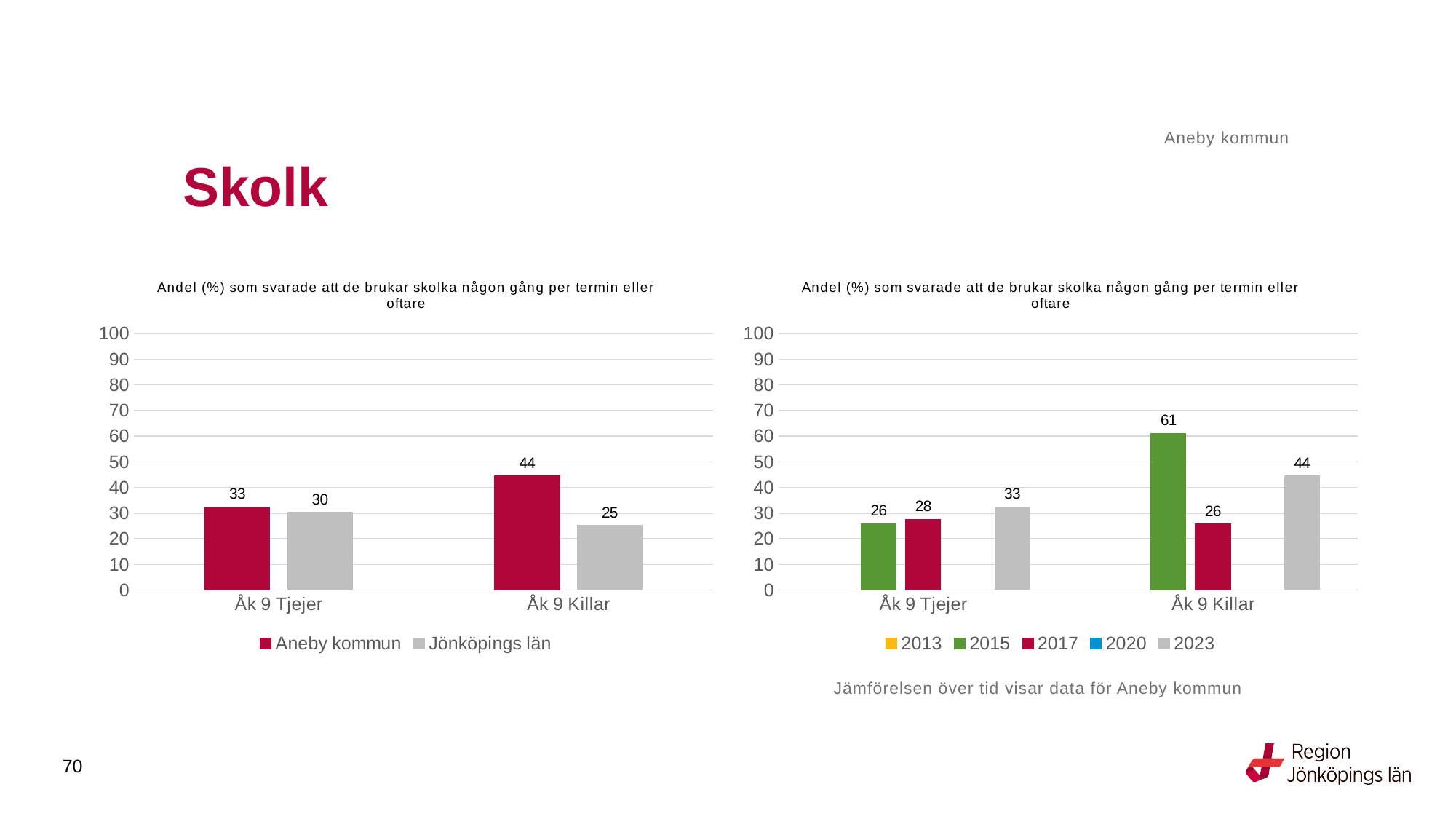
In the right chart, which year has the lowest value for Åk 9 Tjejer? 2015 In the right chart, what is the value for 2017 for Åk 9 Tjejer? 28 In the left chart, what is the value for Aneby kommun for Åk 9 Killar? 44 What kind of chart is the right chart? Bar chart In the right chart, what is the difference between the 2015 and 2017 values for Åk 9 Killar? 35 In the left chart, what is the difference between Aneby kommun and Jönköpings län for Åk 9 Killar? 19 In the right chart, what is the value for 2015 for Åk 9 Killar? 61 In the right chart, which year has the highest value for Åk 9 Killar? 2015 In the left chart, how many series does the legend list? 2 In the right chart, how many series does the legend list? 5 In the left chart, which is larger for Åk 9 Tjejer, Aneby kommun or Jönköpings län? Aneby kommun In the left chart, what is the value for Jönköpings län for Åk 9 Tjejer? 30